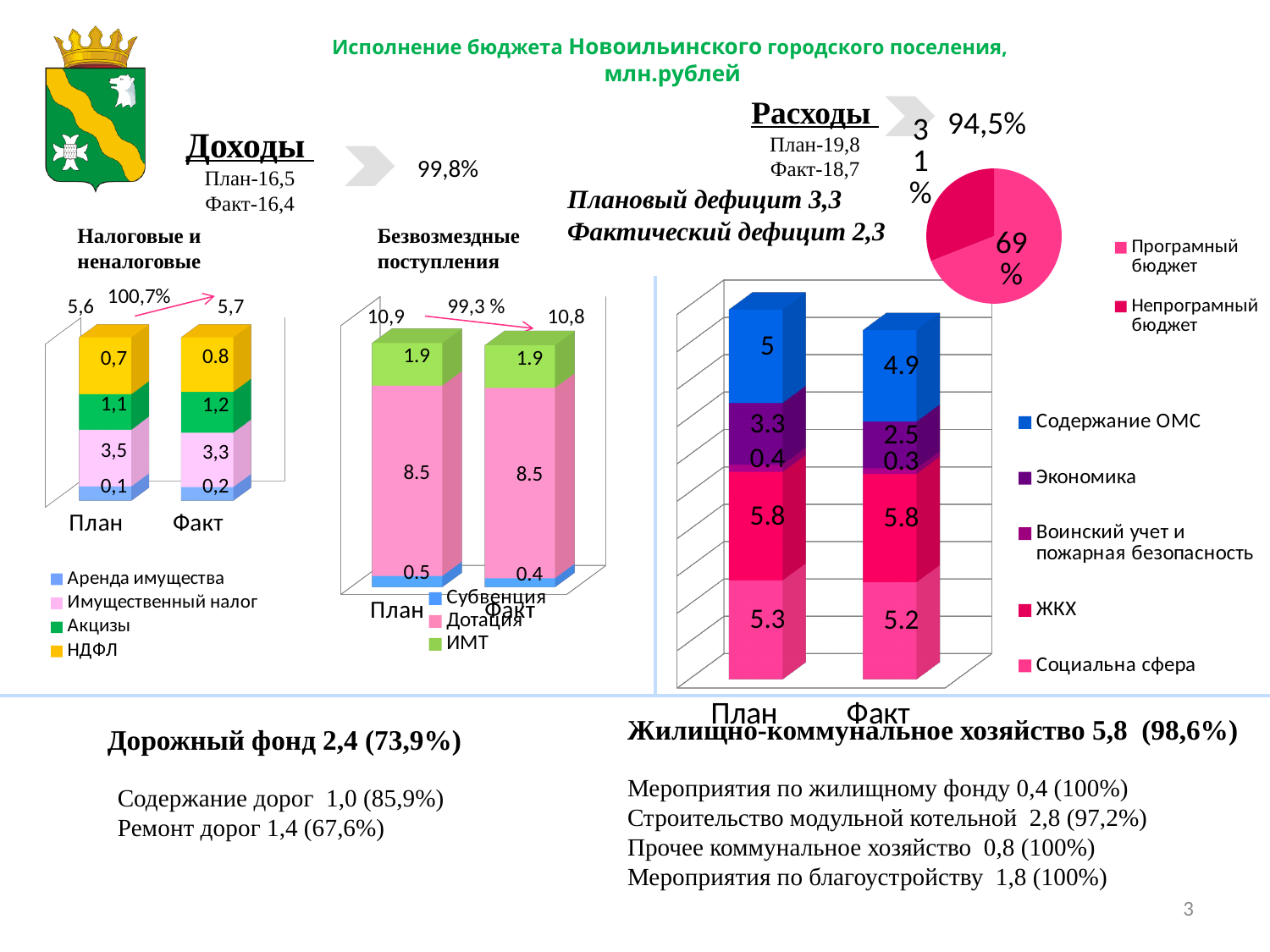
In the 'Расходы' stacked bar chart, what is the value of Экономика for Факт? 2.5 In the pie chart under 'Расходы', how many slices are there? 2 In the 'Безвозмездные поступления' chart, what is the difference between the Субвенция values for План and Факт? 0.1 What type of chart is the 'Расходы' chart with План and Факт bars? Stacked bar chart In the 'Безвозмездные поступления' chart, what is the value of Дотация for Факт? 8.5 In the 'Налоговые и неналоговые' chart, what is the total of the Факт stacked bar? 5,7 In the 'Налоговые и неналоговые' chart, what is the value of Имущественный налог for План? 3,5 In the 'Налоговые и неналоговые' chart, how many series does the legend list? 4 In the 'Расходы' stacked bar chart, what is the difference between Экономика for План and Факт? 0.8 In the pie chart under 'Расходы', what share does Програмный бюджет have? 69% In the 'Безвозмездные поступления' chart, which series has the largest value in the План bar? Дотация In the 'Расходы' stacked bar chart, which is larger: Содержание ОМС for План or for Факт? План